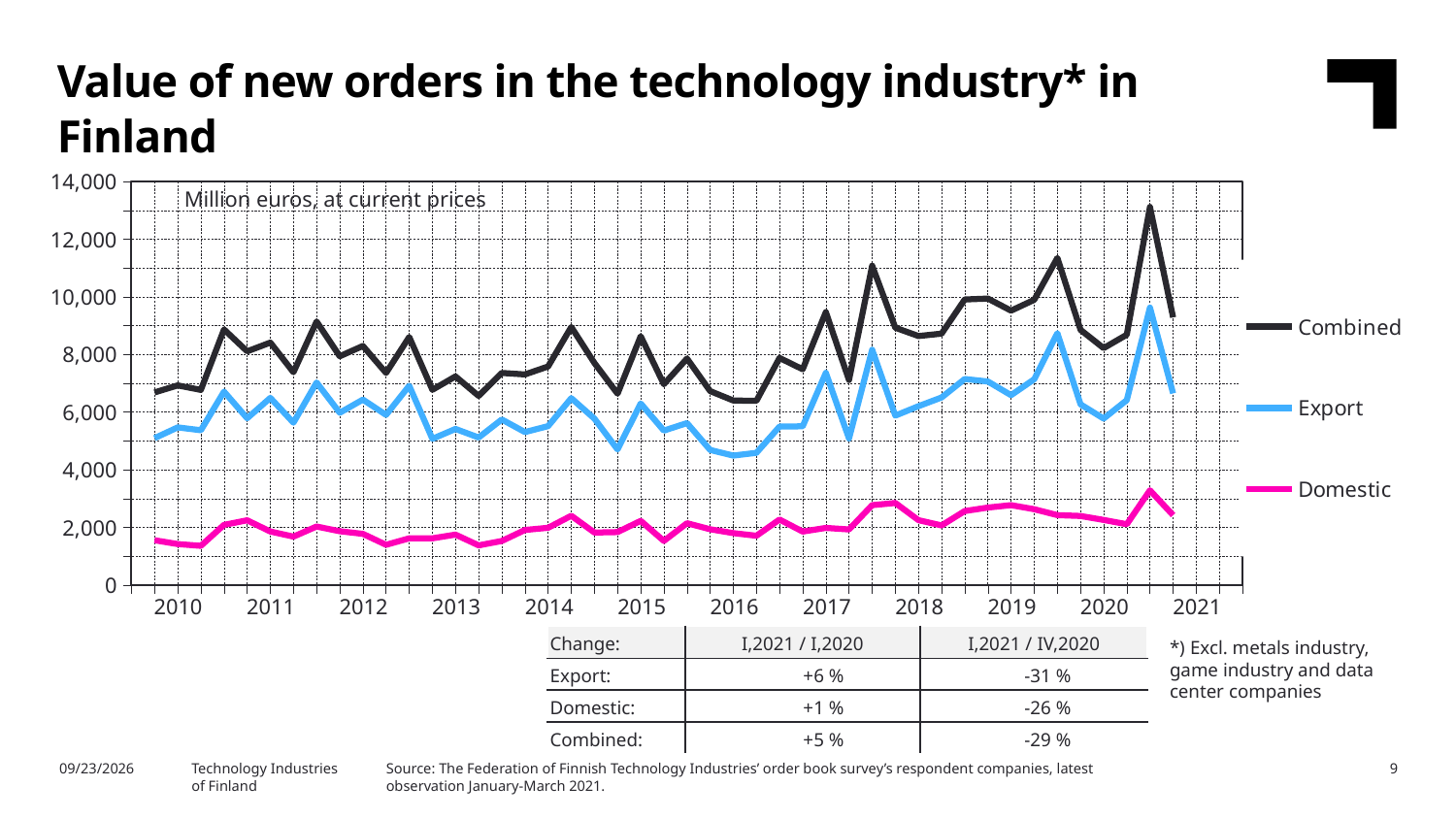
According to the table below the chart, what is the change in Combined orders for I,2021 / IV,2020? -29 % Is the highest value of the Domestic series greater or less than 4,000? less Is the first value of the Combined series in 2010 greater or less than 8,000? less What unit is stated for the values in the chart? Million euros, at current prices Which is larger at the start of 2010: the Export value or the Domestic value? Export What kind of chart is shown on the slide? line chart Is the peak value of the Combined series in late 2020 greater or less than 12,000? greater Which series are listed in the legend? Combined, Export, Domestic Which series has the highest values throughout the chart? Combined How many series does the legend list? 3 Which series has the lowest values throughout the chart? Domestic